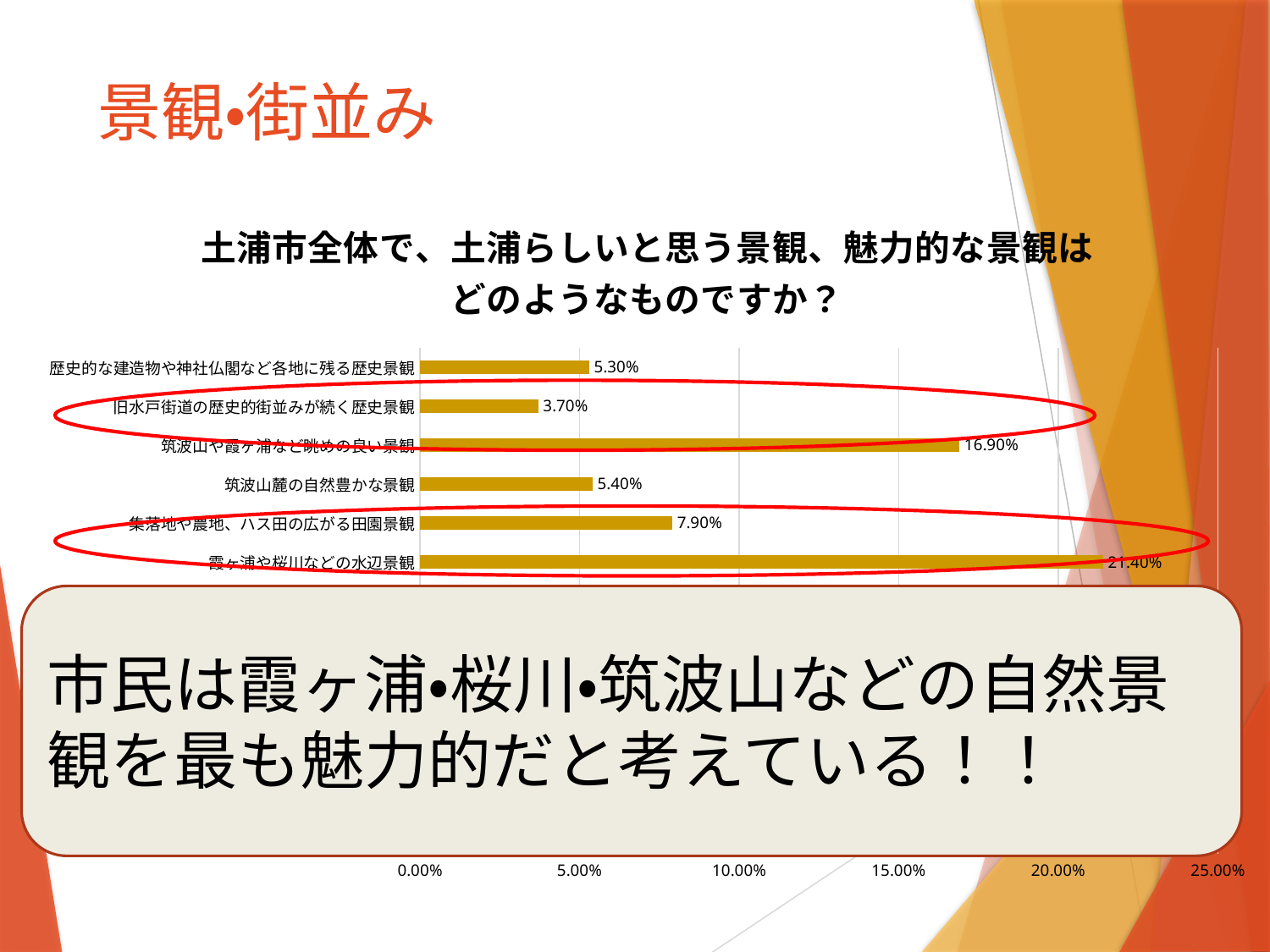
What is the value for 霞ヶ浦や桜川などの水辺景観? 21.40% What is the value for 歴史的な建造物や神社仏閣など各地に残る歴史景観? 5.30% What is the value for 筑波山麓の自然豊かな景観? 5.40% Which is larger, the value for 集落地や農地、ハス田の広がる田園景観 or the value for 筑波山麓の自然豊かな景観? 集落地や農地、ハス田の広がる田園景観 Is the value for 旧水戸街道の歴史的街並みが続く歴史景観 greater or less than 5.00%? less What is the value for 集落地や農地、ハス田の広がる田園景観? 7.90% What is the title of the chart? 土浦市全体で、土浦らしいと思う景観、魅力的な景観はどのようなものですか？ What is the value for 筑波山や霞ヶ浦など眺めの良い景観? 16.90% Is the value for 筑波山や霞ヶ浦など眺めの良い景観 greater or less than 15.00%? greater What kind of chart is shown on the slide? bar chart What is the difference between the values for 霞ヶ浦や桜川などの水辺景観 and 筑波山や霞ヶ浦など眺めの良い景観? 4.50% What is the value for 旧水戸街道の歴史的街並みが続く歴史景観? 3.70%